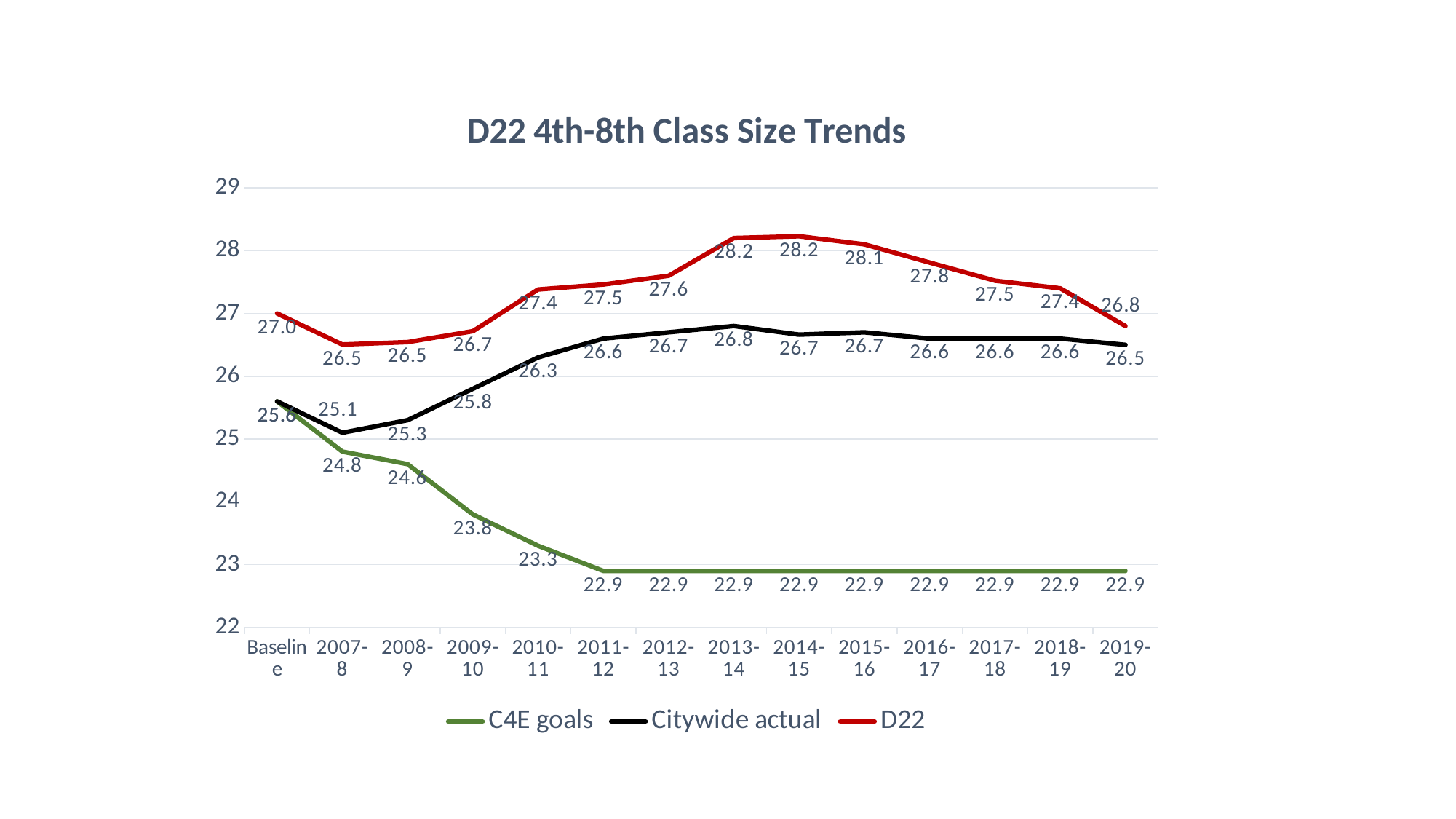
What is the Citywide actual value for 2010-11? 26.3 What is the D22 value for 2013-14? 28.2 Is the C4E goals value for 2011-12 greater or less than 23? less How many categories are shown along the x axis? 14 In which year does the Citywide actual series reach its highest value? 2013-14 In which year is the Citywide actual value lowest? 2007-8 What is the C4E goals value for 2009-10? 23.8 Do the C4E goals values rise or fall from Baseline to 2011-12? fall What kind of chart is shown on the slide? line chart How many series does the legend list? 3 In 2012-13, which is larger: the D22 value or the Citywide actual value? D22 What is the difference between the D22 value in 2013-14 and the D22 value in 2019-20? 1.4